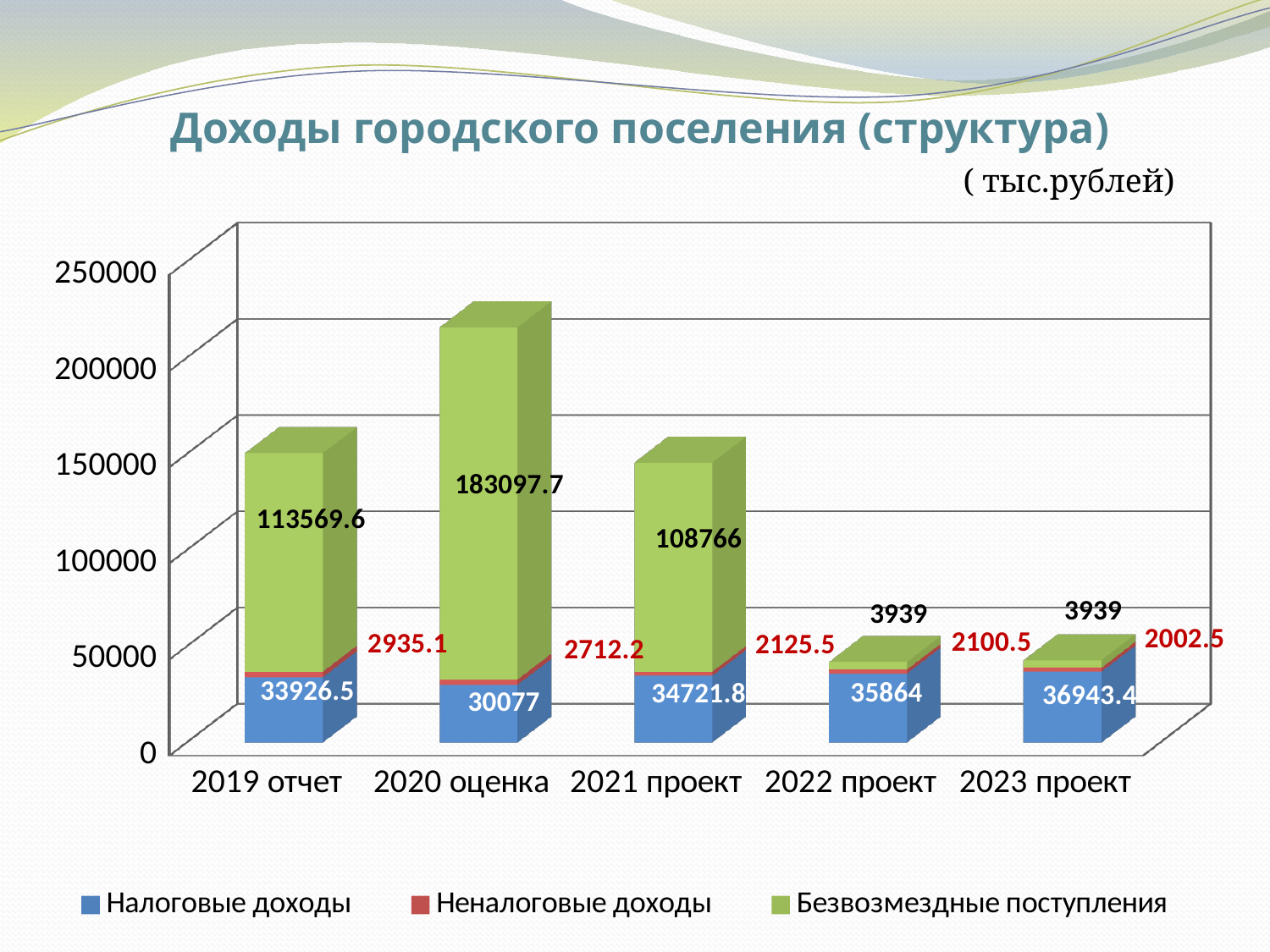
Which colour represents Безвозмездные поступления in the chart? Green Which category has the highest value of Безвозмездные поступления? 2020 оценка What is the difference between Безвозмездные поступления in 2020 оценка and 2019 отчет? 69528.1 What is the value of Налоговые доходы for 2019 отчет? 33926.5 How many categories are shown on the x axis? 5 How many series does the legend list? 3 What kind of chart is shown on the slide? Stacked bar chart What is the total of the stacked bar for 2022 проект? 41903.5 What is the value of Безвозмездные поступления for 2020 оценка? 183097.7 Which is larger: Налоговые доходы in 2023 проект or in 2019 отчет? 2023 проект What is the value of Неналоговые доходы for 2023 проект? 2002.5 Which category has the lowest value of Налоговые доходы? 2020 оценка